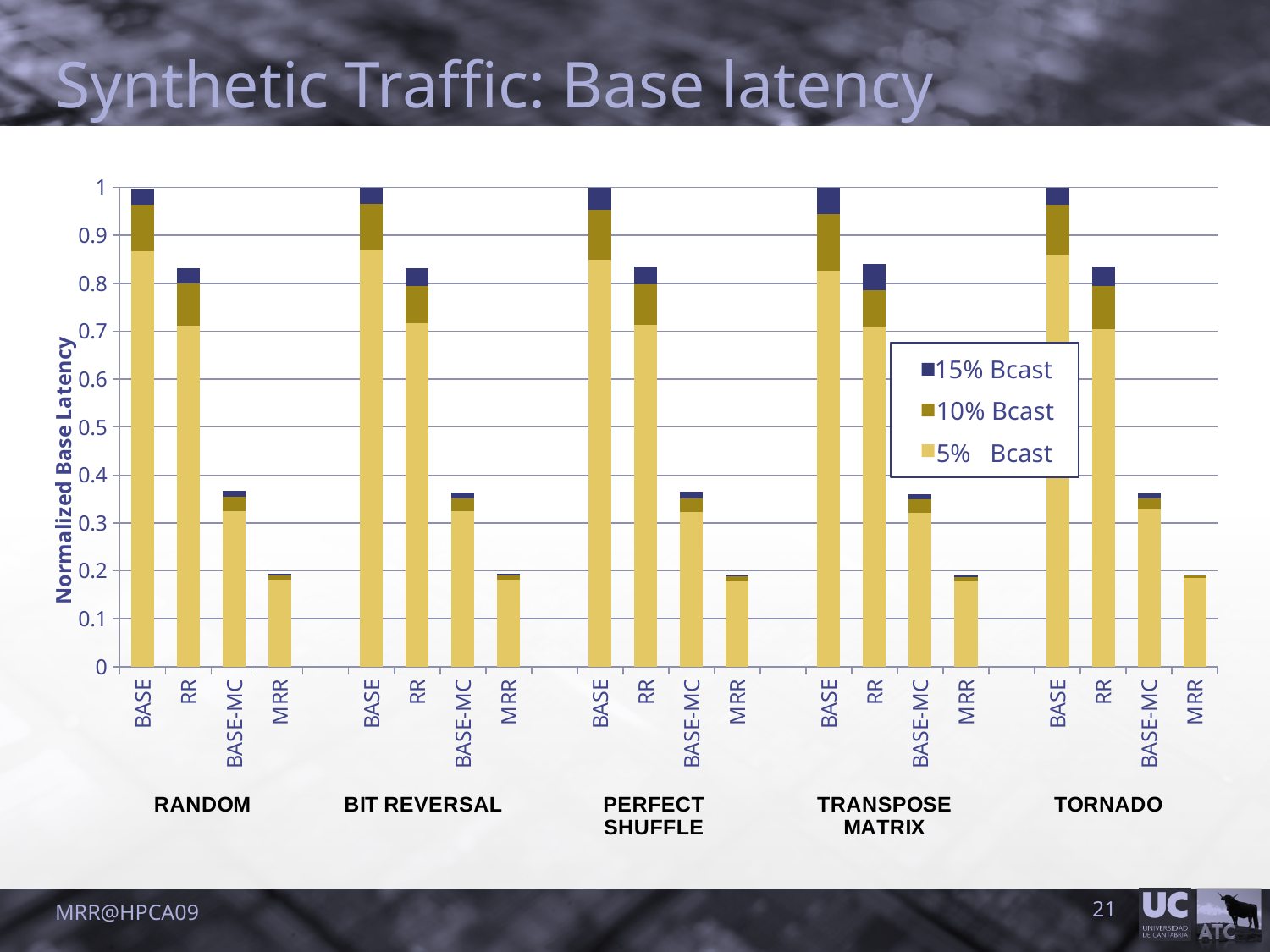
What is the total normalized base latency of the BASE bar in the BIT REVERSAL group? 1 Is the total value for MRR in the PERFECT SHUFFLE group greater or less than 0.2? less Is the total value for RR in the RANDOM group greater or less than 0.8? greater How many series does the legend list? 3 Within the RANDOM group, which scheme has the highest total normalized base latency? BASE What kind of chart is shown on the slide? Stacked bar chart Is the total value for BASE-MC in the TRANSPOSE MATRIX group greater or less than 0.4? less In the TORNADO group, which is larger: the total for RR or the total for BASE-MC? RR How many bars are plotted in total across all groups? 20 How many traffic pattern groups are shown along the x axis? 5 Within the TORNADO group, which scheme has the lowest total normalized base latency? MRR What is the label of the y axis? Normalized Base Latency